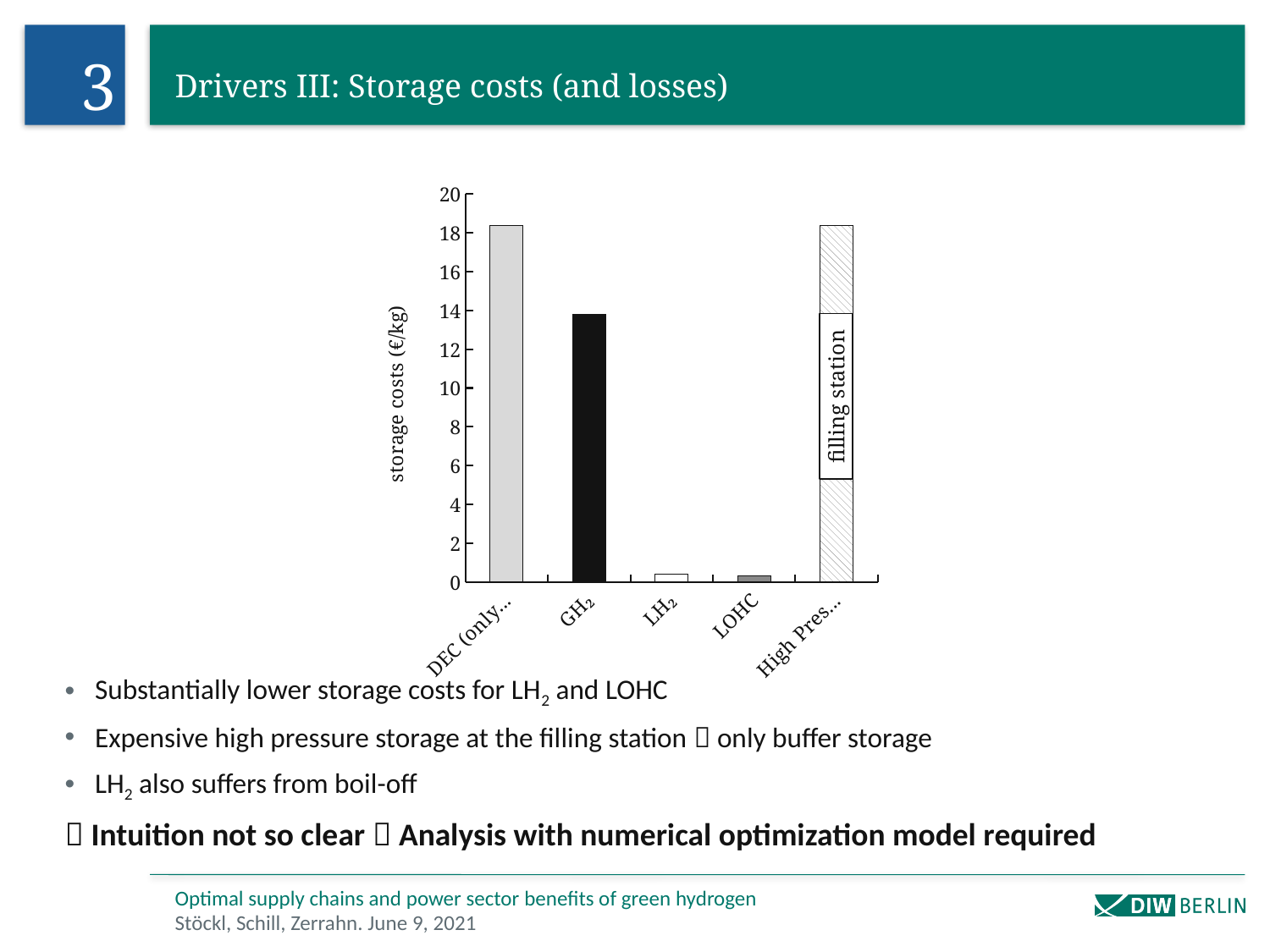
Is the storage cost for GH2 greater or less than 12 €/kg? greater Is the storage cost for High Pres... greater or less than 16 €/kg? greater What text is written inside the hatched bar for High Pres...? filling station Is the storage cost for LH2 greater or less than 2 €/kg? less How many categories are shown on the x axis of the chart? 5 Which has the higher storage cost, LOHC or High Pres...? High Pres... What is the label of the y axis of the chart? storage costs (€/kg) Which has the higher storage cost, GH2 or LH2? GH2 Which has the higher storage cost, DEC (only...) or GH2? DEC (only...) What kind of chart is shown on the slide? bar chart